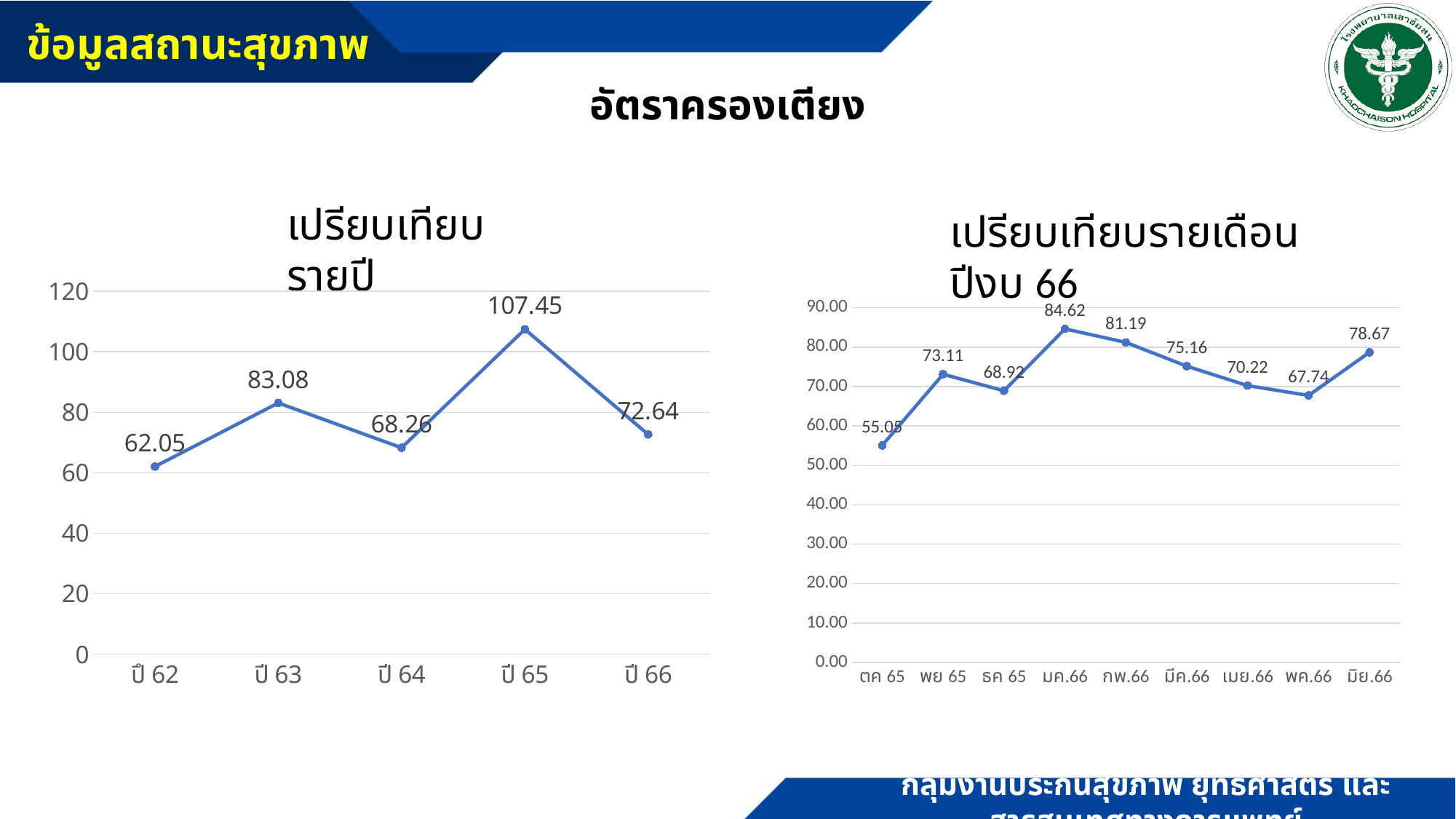
In the left chart (เปรียบเทียบรายปี), what is the difference between the values for ปี 65 and ปี 66? 34.81 In the left chart (เปรียบเทียบรายปี), how many years are plotted? 5 In the right chart (เปรียบเทียบรายเดือนปีงบ 66), which is larger, the value for พย 65 or the value for ธค 65? พย 65 What type of chart is the right chart (เปรียบเทียบรายเดือนปีงบ 66)? line chart In the left chart (เปรียบเทียบรายปี), what is the value for ปี 65? 107.45 In the left chart (เปรียบเทียบรายปี), is the value for ปี 63 greater or less than 80? greater In the left chart (เปรียบเทียบรายปี), which year has the lowest value? ปี 62 In the right chart (เปรียบเทียบรายเดือนปีงบ 66), do the values rise or fall from มค.66 to พค.66? fall In the right chart (เปรียบเทียบรายเดือนปีงบ 66), what is the value for มค.66? 84.62 In the right chart (เปรียบเทียบรายเดือนปีงบ 66), which month has the lowest value? ตค 65 What is the title of the left chart? เปรียบเทียบรายปี In the right chart (เปรียบเทียบรายเดือนปีงบ 66), how many months are plotted? 9